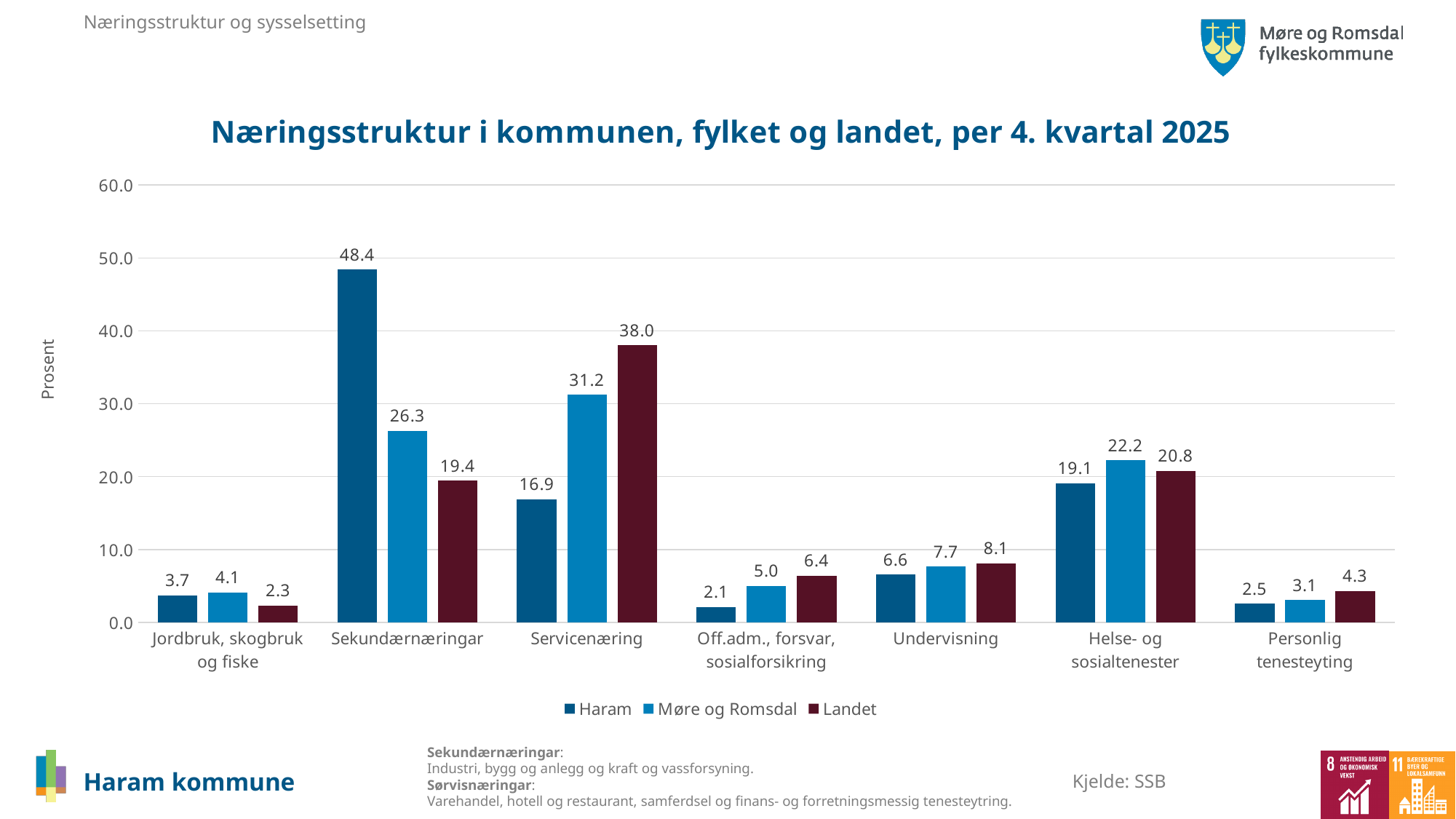
What is the value for Haram in Sekundærnæringar? 48.4 Is the value for Landet in Servicenæring greater or less than 30.0? greater Which is larger in Servicenæring: the value for Haram or the value for Møre og Romsdal? Møre og Romsdal Which category has the lowest value for Landet? Jordbruk, skogbruk og fiske How many categories are shown on the x axis? 7 How many series does the legend list? 3 What is the value for Landet in Servicenæring? 38.0 Which category has the highest value for Haram? Sekundærnæringar What is the difference between the Haram and Landet values in Sekundærnæringar? 29.0 What is the label of the y axis? Prosent What kind of chart is shown on the slide? Bar chart What is the value for Møre og Romsdal in Helse- og sosialtenester? 22.2